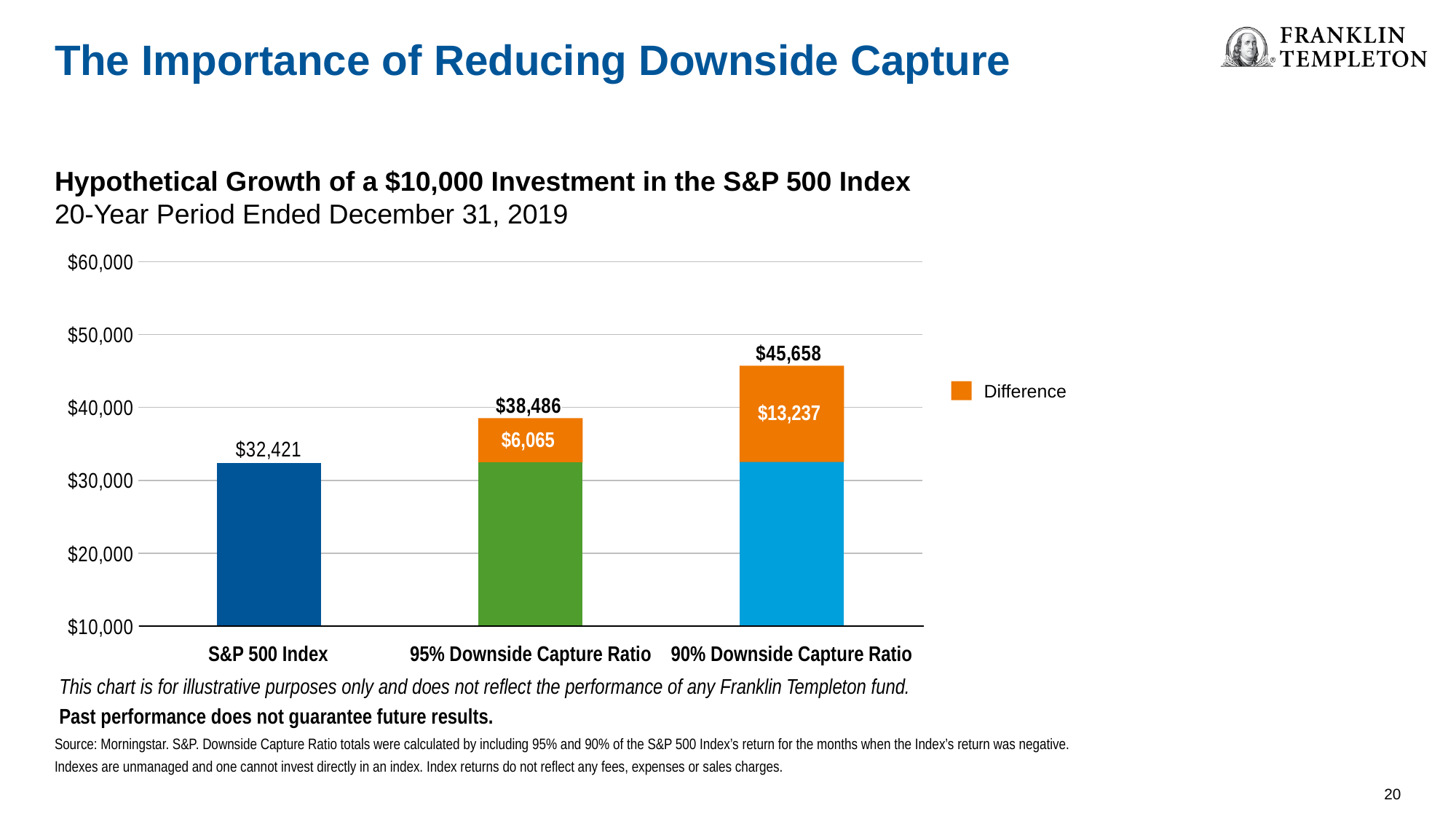
What is the hypothetical growth value shown for the S&P 500 Index? $32,421 What is the total value shown above the 90% Downside Capture Ratio bar? $45,658 Which category has the highest total value? 90% Downside Capture Ratio What is the Difference amount labelled on the 90% Downside Capture Ratio bar? $13,237 Which category has the lowest value? S&P 500 Index What is the Difference amount labelled on the 95% Downside Capture Ratio bar? $6,065 How many categories are shown on the x axis? 3 What is the total value shown above the 95% Downside Capture Ratio bar? $38,486 Which is larger: the total for the 95% Downside Capture Ratio or the total for the 90% Downside Capture Ratio? 90% Downside Capture Ratio Is the value for the S&P 500 Index greater or less than $40,000? less What is the difference between the total for the 90% Downside Capture Ratio and the S&P 500 Index value? $13,237 What kind of chart is shown on the slide? Bar chart